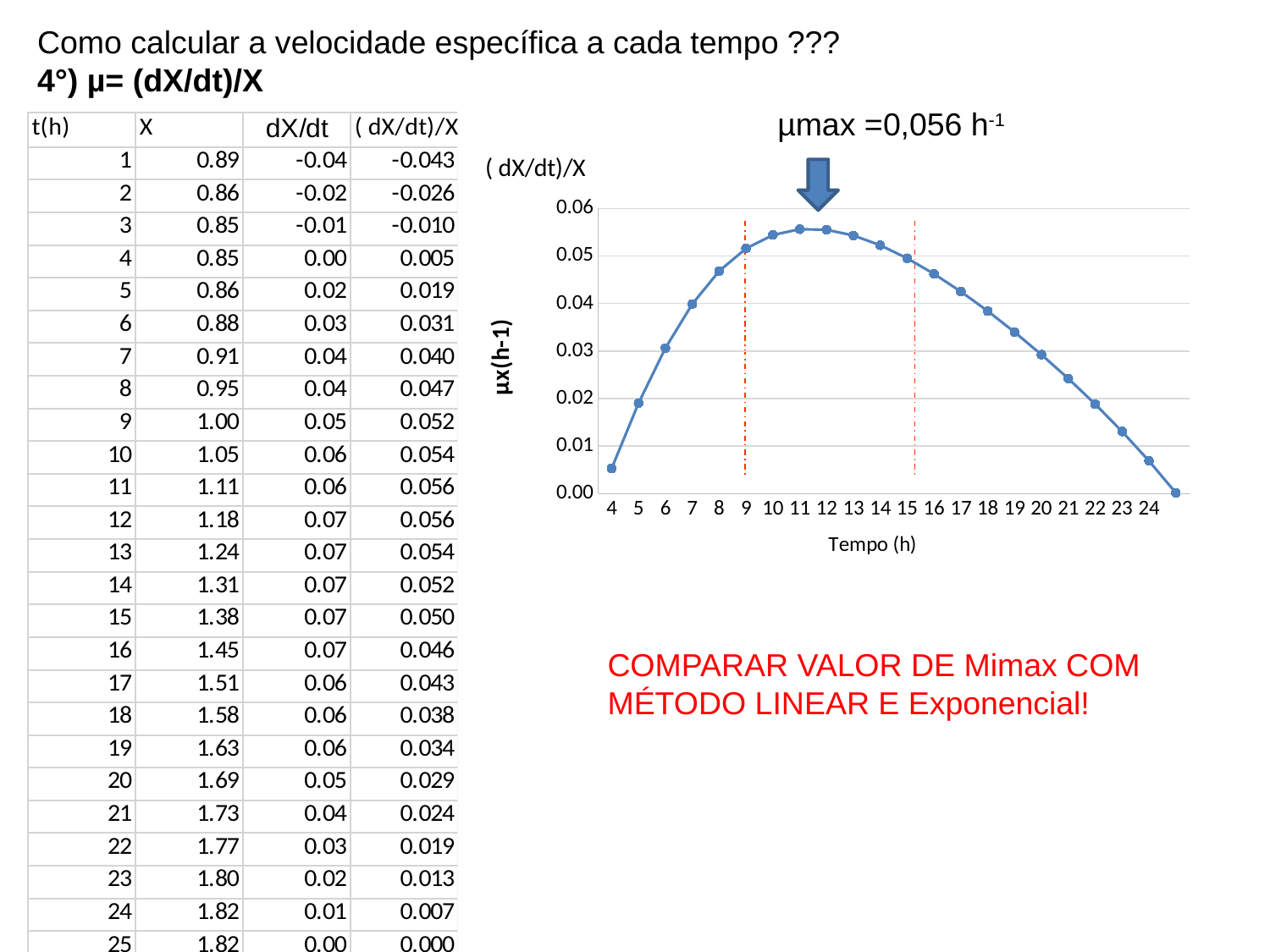
Is the value for Tempo 16 greater or less than 0.05? less What kind of chart is shown on the slide? line chart Which is larger, the value at Tempo 9 or the value at Tempo 17? Tempo 9 Is the value for Tempo 4 greater or less than 0.01? less What is the title of the x axis of the chart? Tempo (h) How do the values change as Tempo increases from 4 to the end of the axis? rise then fall Is the value for Tempo 10 greater or less than 0.05? greater Which is larger, the value at Tempo 5 or the value at Tempo 21? Tempo 21 What value of μmax is annotated above the chart? 0,056 h-1